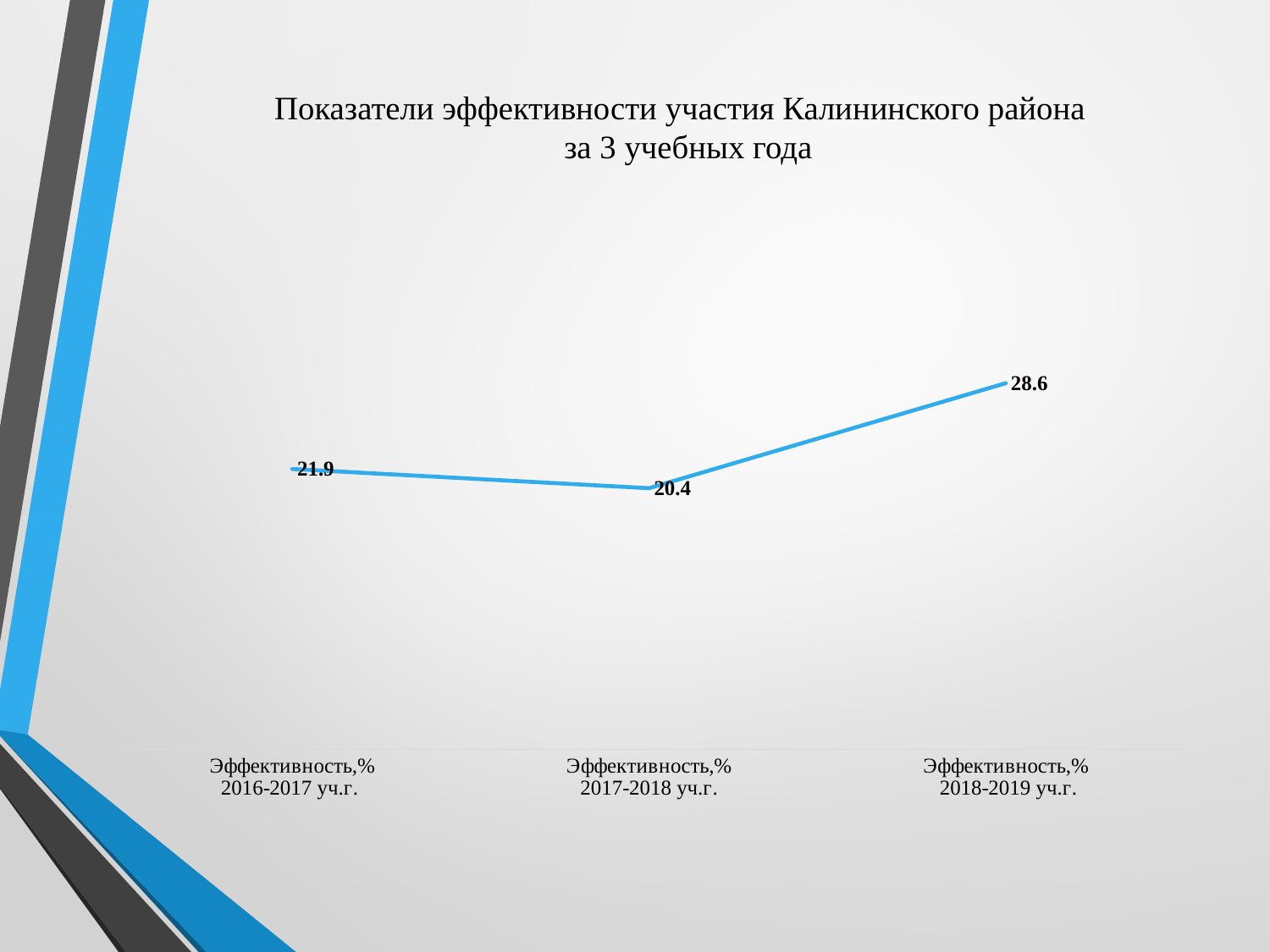
Which academic year has the highest value? 2018-2019 уч.г. What is the value for Эффективность,% 2017-2018 уч.г.? 20.4 Which academic year has the lowest value? 2017-2018 уч.г. How many data points are plotted on the chart? 3 Which is larger, the value for 2016-2017 уч.г. or the value for 2018-2019 уч.г.? 2018-2019 уч.г. What is the difference between the values for 2016-2017 уч.г. and 2017-2018 уч.г.? 1.5 Does the value rise or fall from 2017-2018 уч.г. to 2018-2019 уч.г.? rise What is the value for Эффективность,% 2016-2017 уч.г.? 21.9 What is the title of the chart? Показатели эффективности участия Калининского района за 3 учебных года What type of chart is shown on the slide? line chart What is the difference between the values for 2018-2019 уч.г. and 2017-2018 уч.г.? 8.2 What is the value for Эффективность,% 2018-2019 уч.г.? 28.6